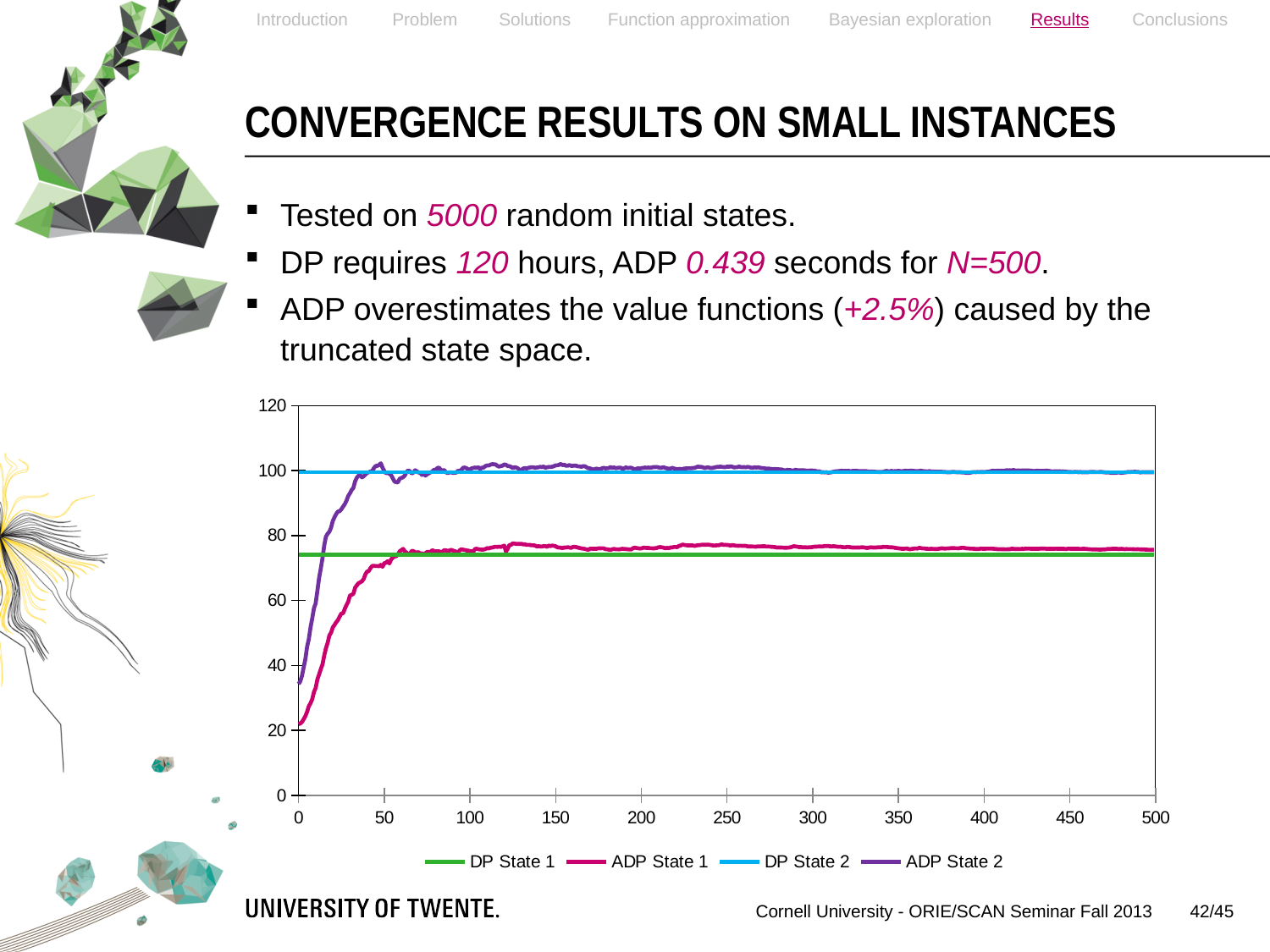
Is the value of ADP State 2 at x = 0 greater or less than 60? less What is the highest value shown on the chart's y axis? 120 Is the value of ADP State 1 at x = 500 greater or less than 60? greater Is the value of DP State 1 greater or less than 60? greater Which series has the lowest value at x = 0? ADP State 1 Which is larger, the value of DP State 2 or the value of DP State 1? DP State 2 How many series does the chart legend list? 4 Which series are listed in the chart legend? DP State 1, ADP State 1, DP State 2, ADP State 2 How does the ADP State 1 line change as x increases from 0 to 500? rises sharply, then levels off What kind of chart is shown on the slide? line chart